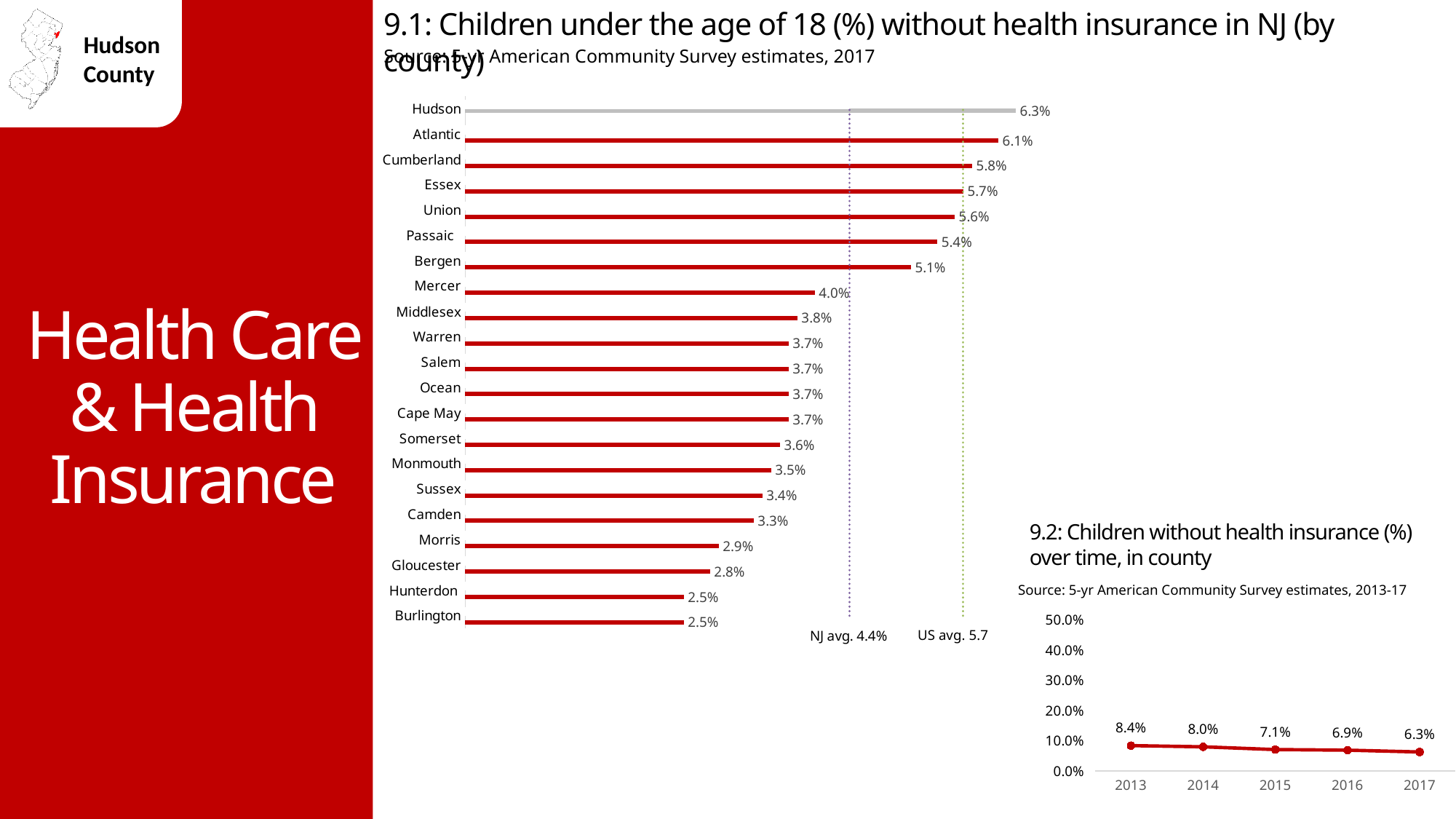
In chart 9.1, what is the difference between the values for Hudson and Burlington? 3.8% In chart 9.2, what is the difference between the 2013 and 2017 values? 2.1% What kind of chart is chart 9.2? Line chart In chart 9.1, what NJ average is marked by the dotted line? 4.4% In chart 9.1, which county has the highest percentage of children without health insurance? Hudson In chart 9.1, which has a larger value, Passaic or Mercer? Passaic In chart 9.1, what is the value for Bergen? 5.1% What kind of chart is chart 9.1? Bar chart In chart 9.1 (children under 18 without health insurance by county), what is the value for Hudson? 6.3% In chart 9.2, do the values rise or fall from 2013 to 2017? Fall In chart 9.1, how many counties are shown? 21 In chart 9.2 (children without health insurance over time), what is the value for 2013? 8.4%